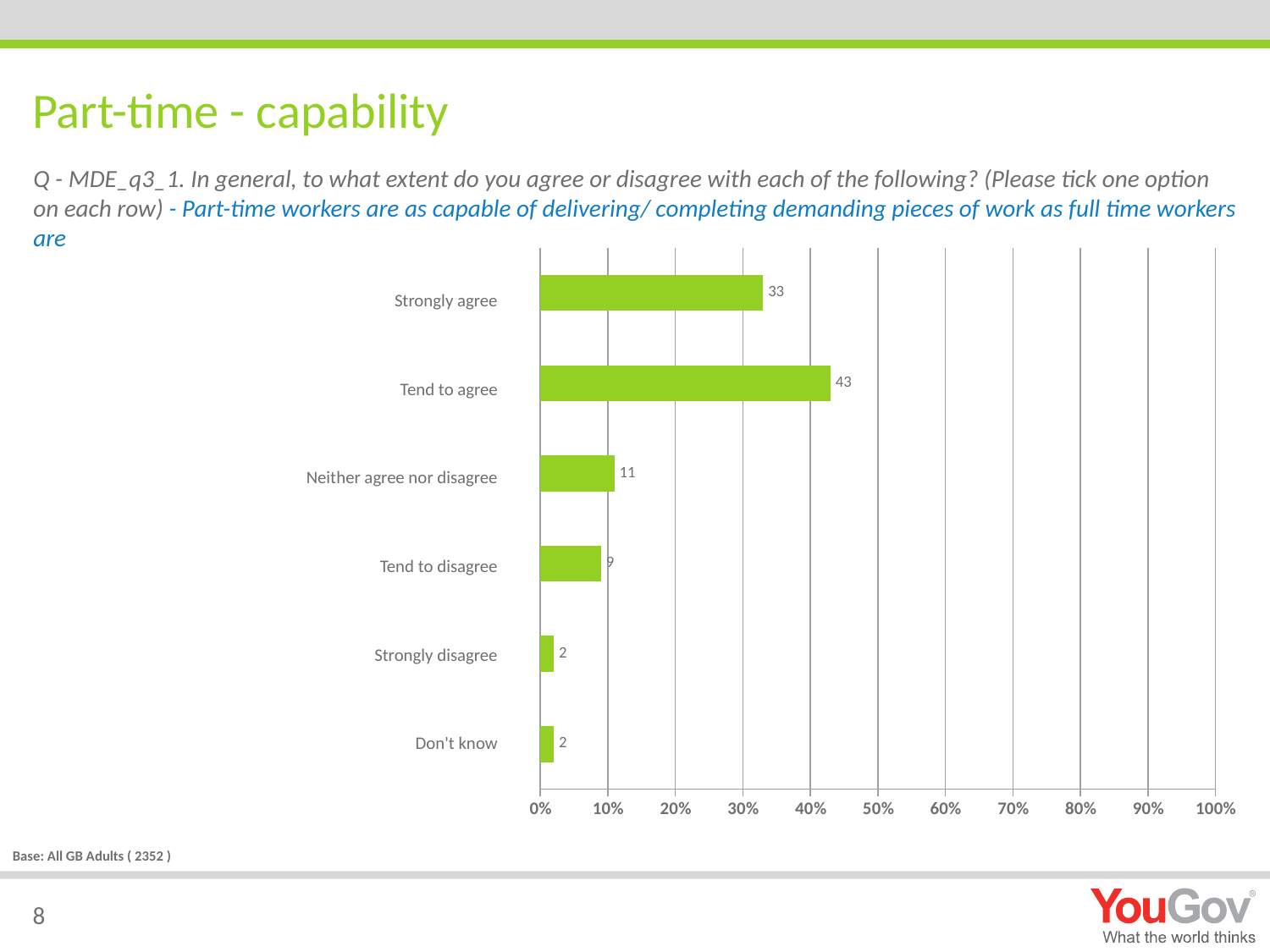
Which category has the highest value? Tend to agree How many categories are shown in the chart? 6 Is the value for Strongly agree greater or less than 30%? greater Which is larger, the value for Neither agree nor disagree or the value for Tend to disagree? Neither agree nor disagree What is the base shown below the chart? All GB Adults ( 2352 ) What is the value for Strongly agree? 33 What is the value for Tend to disagree? 9 What is the value for Tend to agree? 43 What is the total of the values for Strongly disagree and Don't know? 4 What is the difference between the values for Tend to agree and Strongly agree? 10 What kind of chart is shown on the slide? Bar chart What is the value for Neither agree nor disagree? 11